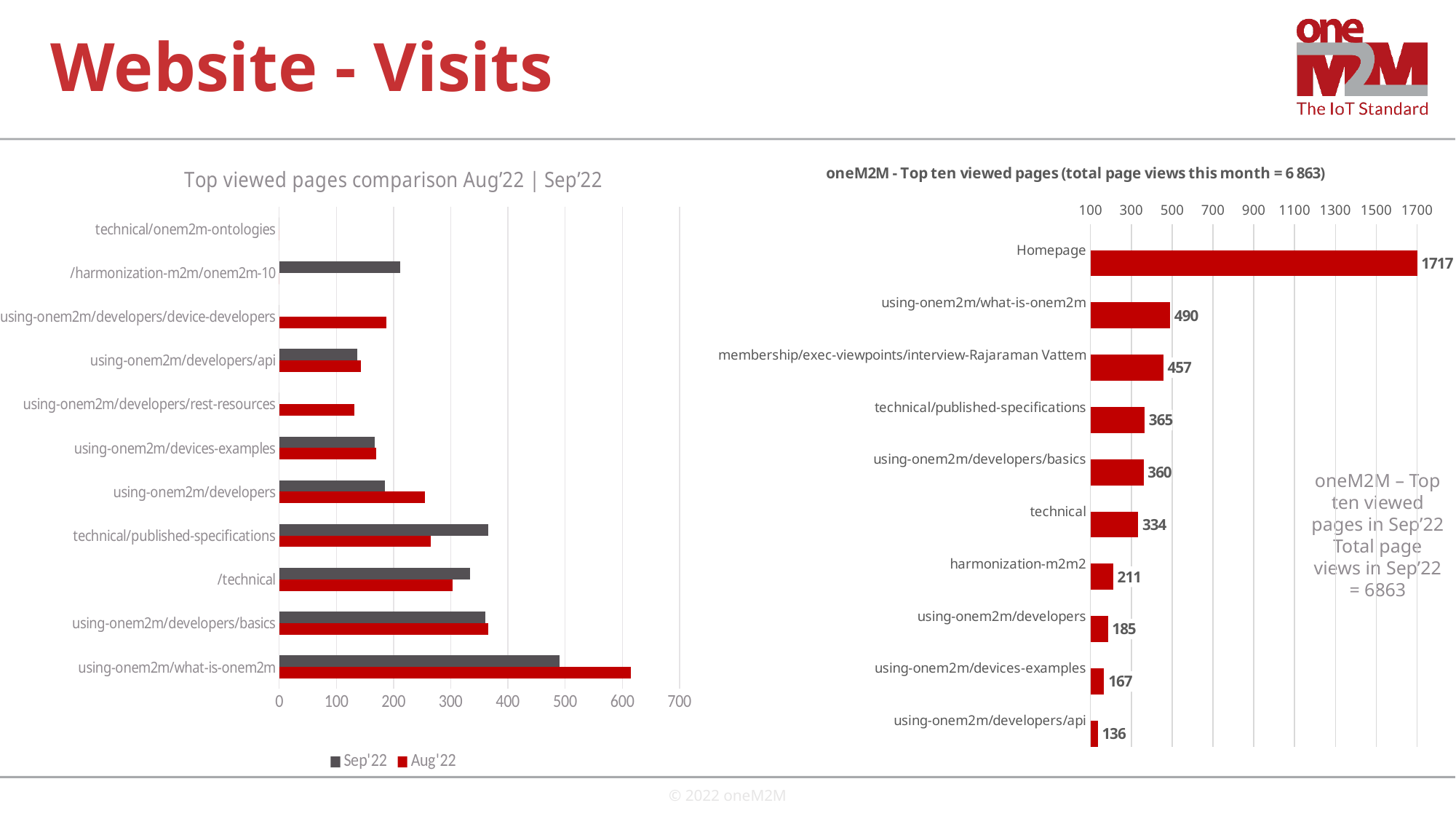
In the 'oneM2M - Top ten viewed pages' chart, what is the value for technical/published-specifications? 365 In the 'oneM2M - Top ten viewed pages' chart, what is the value for harmonization-m2m2? 211 What type of chart is the 'Top viewed pages comparison Aug'22 | Sep'22' chart? Bar chart In the 'oneM2M - Top ten viewed pages' chart, which is larger: using-onem2m/developers or using-onem2m/devices-examples? using-onem2m/developers In the 'Top viewed pages comparison Aug'22 | Sep'22' chart, is the Aug'22 value for using-onem2m/what-is-onem2m greater or less than 600? greater In the 'oneM2M - Top ten viewed pages' chart, what is the value for Homepage? 1717 How many series does the legend of the 'Top viewed pages comparison Aug'22 | Sep'22' chart list? 2 How many pages are shown in the 'oneM2M - Top ten viewed pages' chart? 10 In the 'oneM2M - Top ten viewed pages' chart, what is the difference between using-onem2m/what-is-onem2m and membership/exec-viewpoints/interview-Rajaraman Vattem? 33 In the 'oneM2M - Top ten viewed pages' chart, which page has the lowest value? using-onem2m/developers/api In the 'Top viewed pages comparison Aug'22 | Sep'22' chart, is the Aug'22 value for technical/published-specifications greater or less than 300? less In the 'Top viewed pages comparison Aug'22 | Sep'22' chart, which colour represents Sep'22? Dark grey